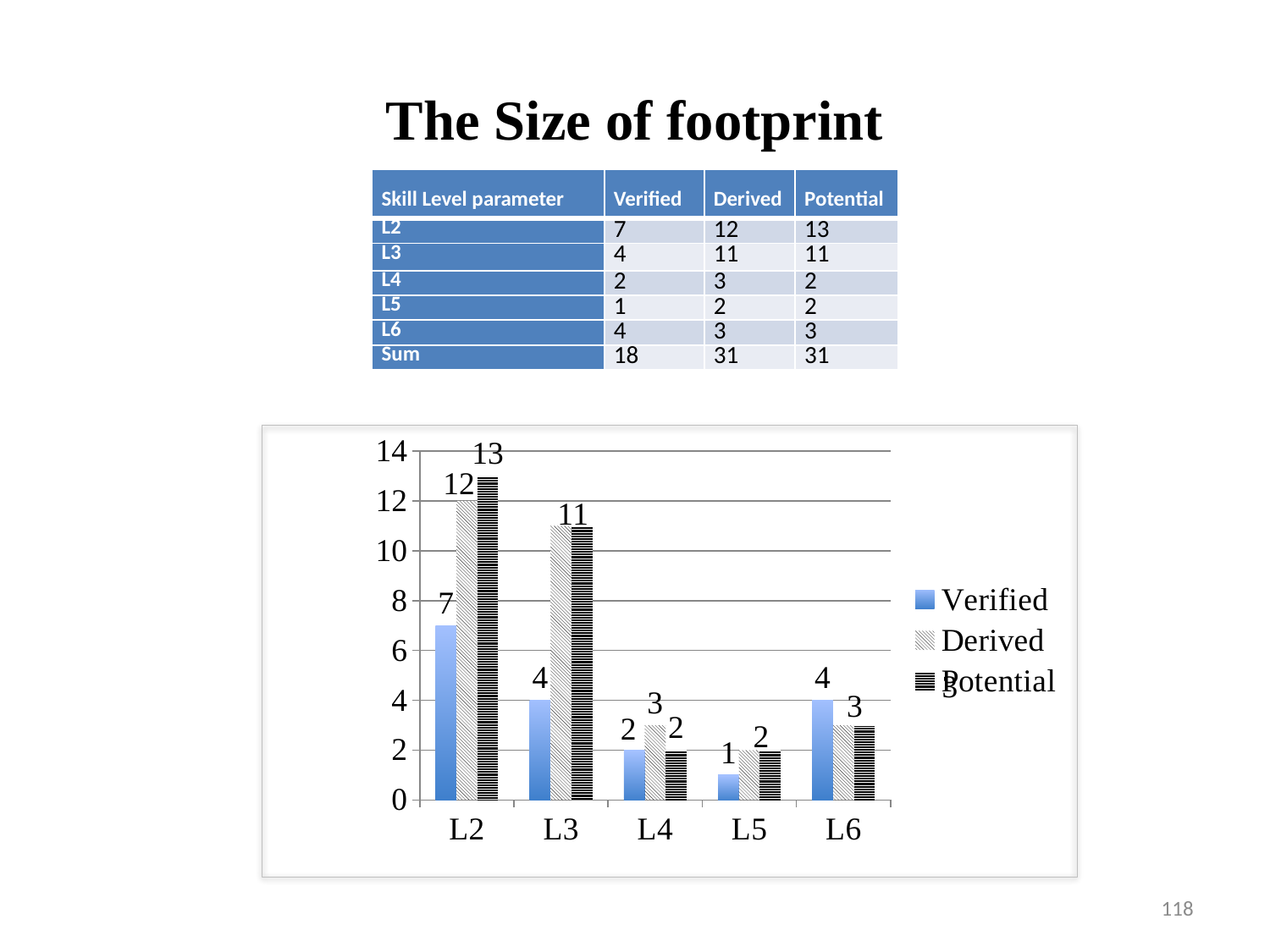
What is the Potential value for L2 in the chart? 13 How many series does the chart legend list? 3 What kind of chart is shown on the slide? Bar chart Which is larger, the Derived value for L2 or the Derived value for L3? L2 Do the Verified values rise or fall from L2 to L5? Fall Which skill level has the lowest Verified value? L5 What is the Verified value for L2 in the chart? 7 Which skill level has the highest Verified value? L2 How many skill level categories are shown on the x axis of the chart? 5 What is the Verified value for L5 in the chart? 1 What is the difference between the Potential and Verified values for L2? 6 What is the Derived value for L3 in the chart? 11